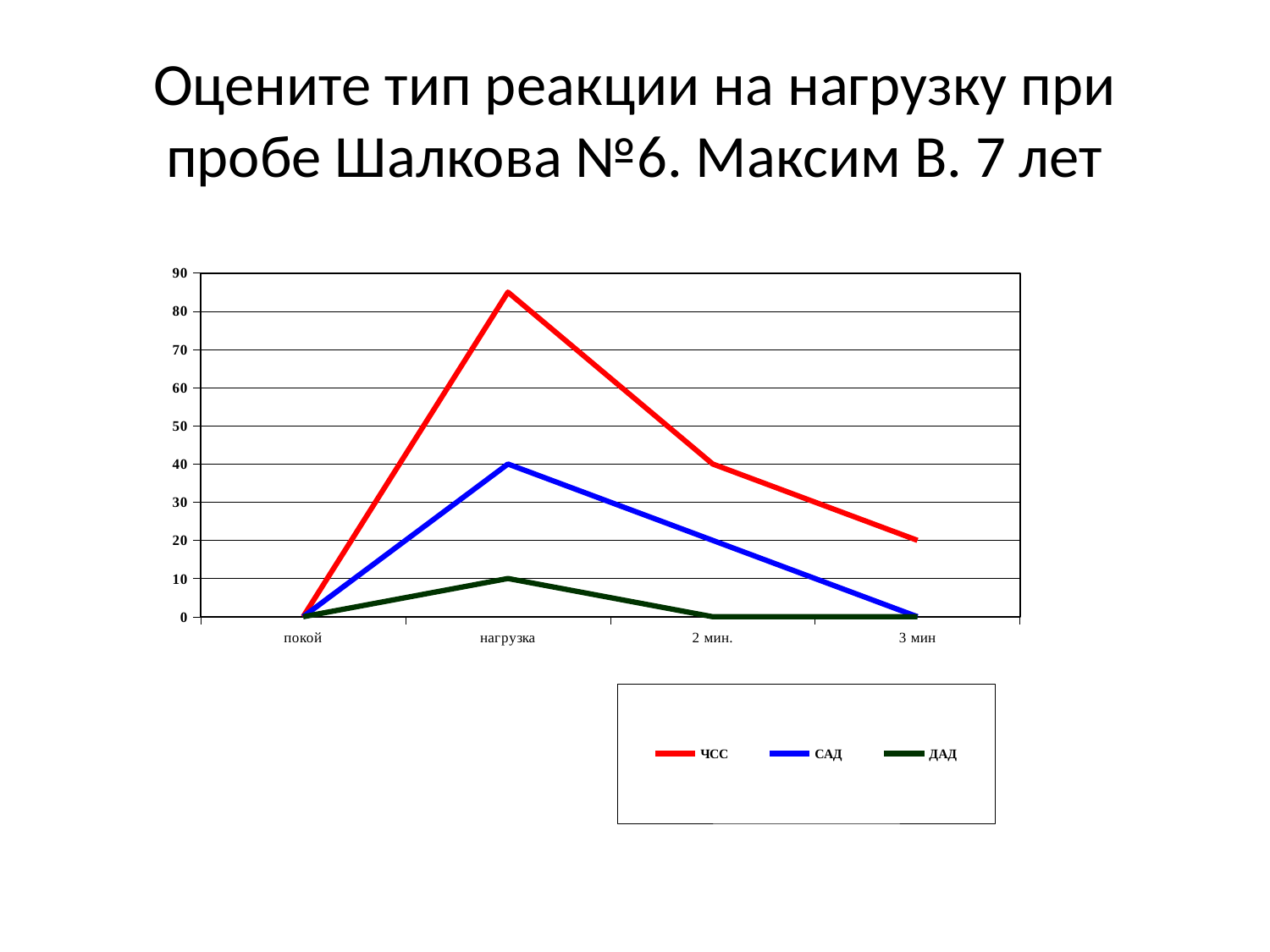
What kind of chart is shown on the slide? line chart How many series does the legend list? 3 What is the difference between ЧСС and САД at 2 мин.? 20 How many categories are shown on the x axis? 4 What is the value of ЧСС at 3 мин? 20 What is the value of ДАД at нагрузка? 10 What is the value of САД at нагрузка? 40 Which is larger at 2 мин.: ЧСС or САД? ЧСС Is the value of ЧСС at нагрузка greater or less than 80? greater At which category does ЧСС reach its highest value? нагрузка Which colour is used for the ДАД series? dark green What is the value of ЧСС at 2 мин.? 40